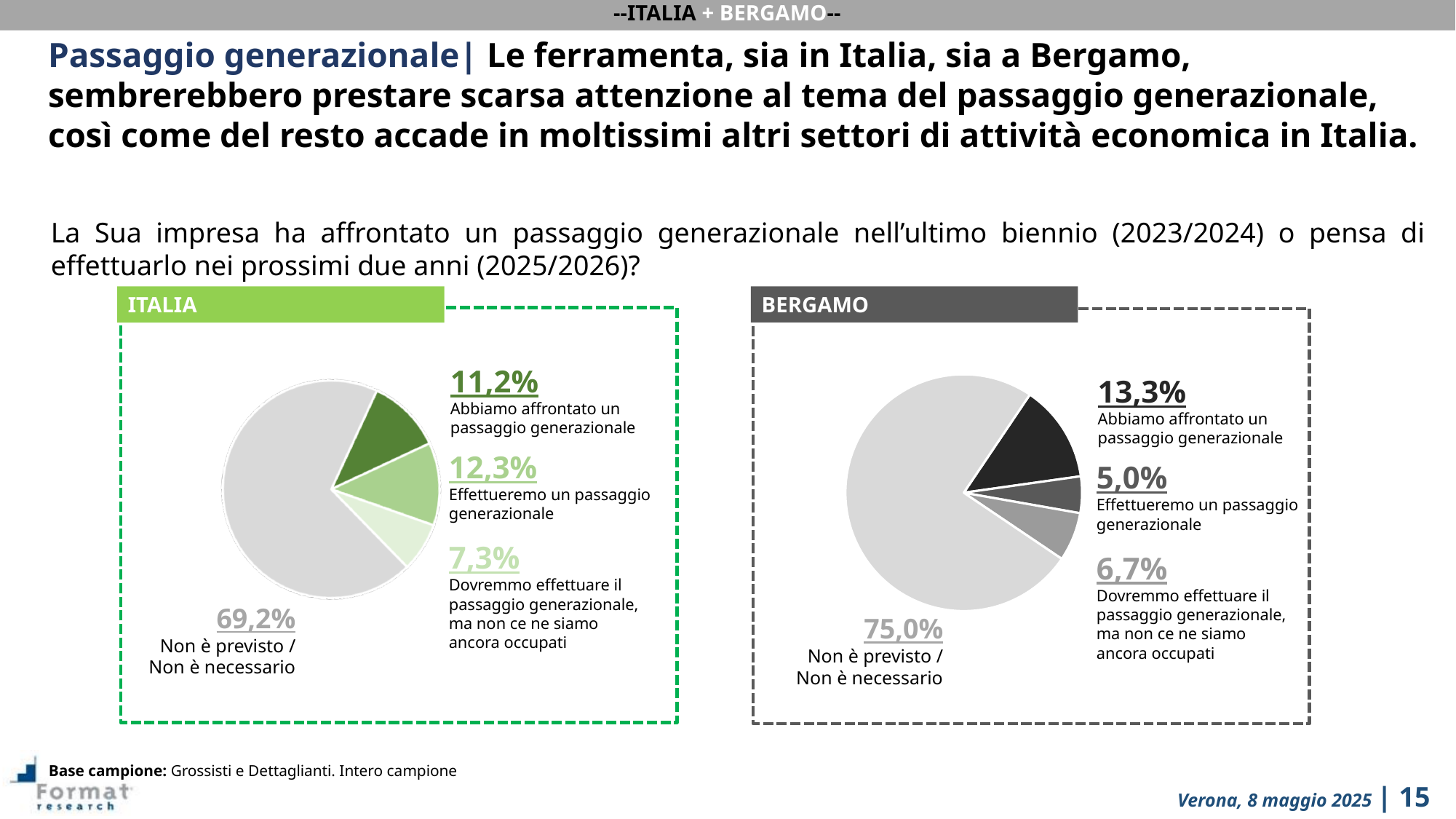
In the BERGAMO pie chart, what share of respondents answered "Abbiamo affrontato un passaggio generazionale"? 13,3% In the ITALIA pie chart, what share of respondents answered "Dovremmo effettuare il passaggio generazionale, ma non ce ne siamo ancora occupati"? 7,3% In the ITALIA pie chart, which response has the largest share? Non è previsto / Non è necessario What type of chart is used for the BERGAMO data? Pie chart In the BERGAMO pie chart, what share of respondents answered "Effettueremo un passaggio generazionale"? 5,0% How many slices does the ITALIA pie chart have? 4 In the ITALIA pie chart, what is the combined share of "Abbiamo affrontato un passaggio generazionale" and "Effettueremo un passaggio generazionale"? 23,5% What colour scheme is used for the slices of the BERGAMO pie chart? Shades of grey Which is larger: the "Effettueremo un passaggio generazionale" share in the ITALIA chart or in the BERGAMO chart? ITALIA In the BERGAMO pie chart, which response has the smallest share? Effettueremo un passaggio generazionale In the ITALIA pie chart, what share of respondents answered "Non è previsto / Non è necessario"? 69,2% What is the difference between the "Non è previsto / Non è necessario" share in the BERGAMO chart and in the ITALIA chart? 5,8%